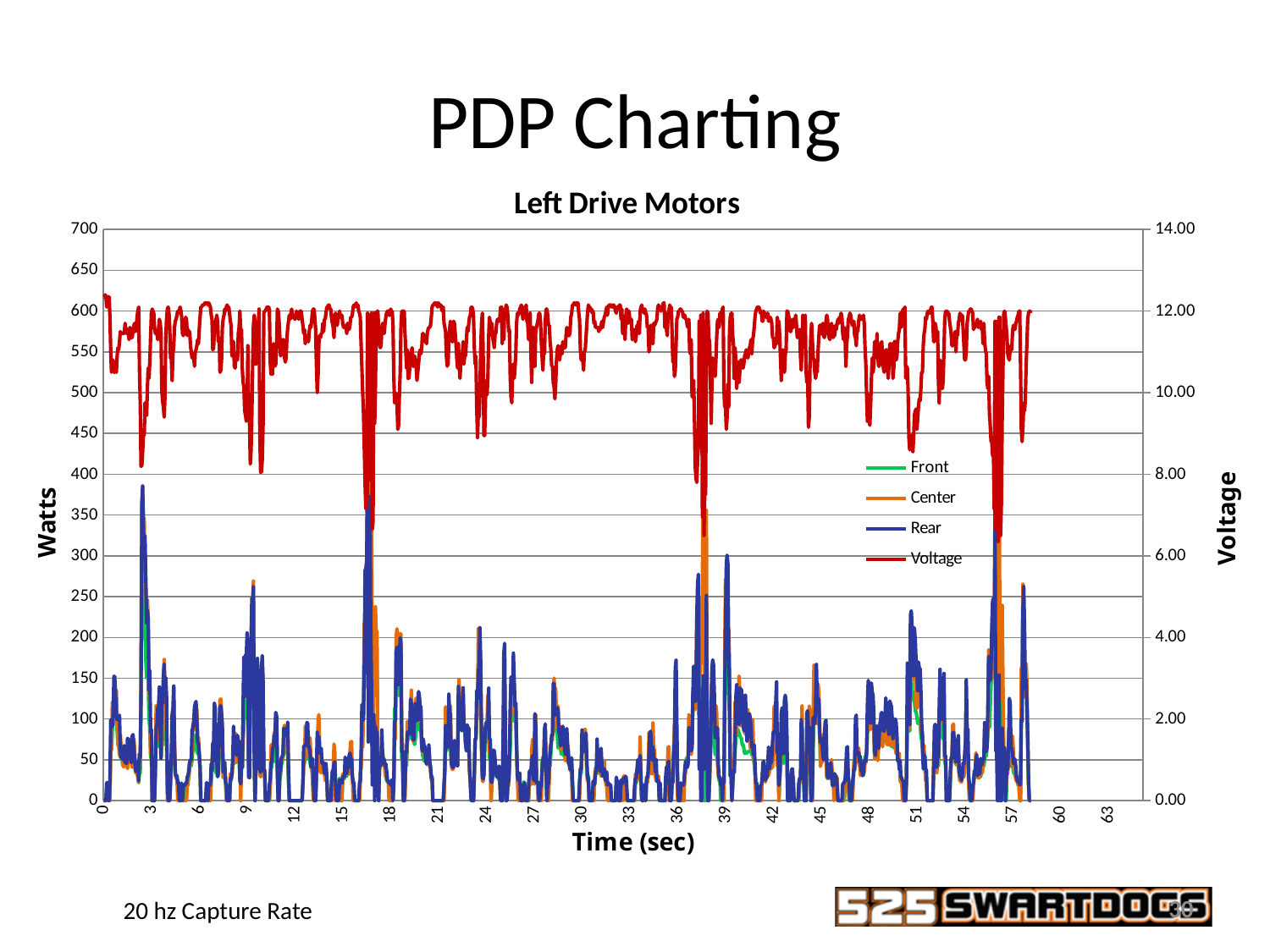
Is the Voltage value at time 0 seconds greater or less than 10.00? greater How many series does the legend of the chart list? 4 Is the peak of the Rear series near 3 seconds greater or less than 350 watts? greater What is the title of the chart? Left Drive Motors What is the label of the x axis of the chart? Time (sec) Is the lowest Voltage value near 17 seconds greater or less than 8.00? less What kind of chart is shown on the slide? line chart